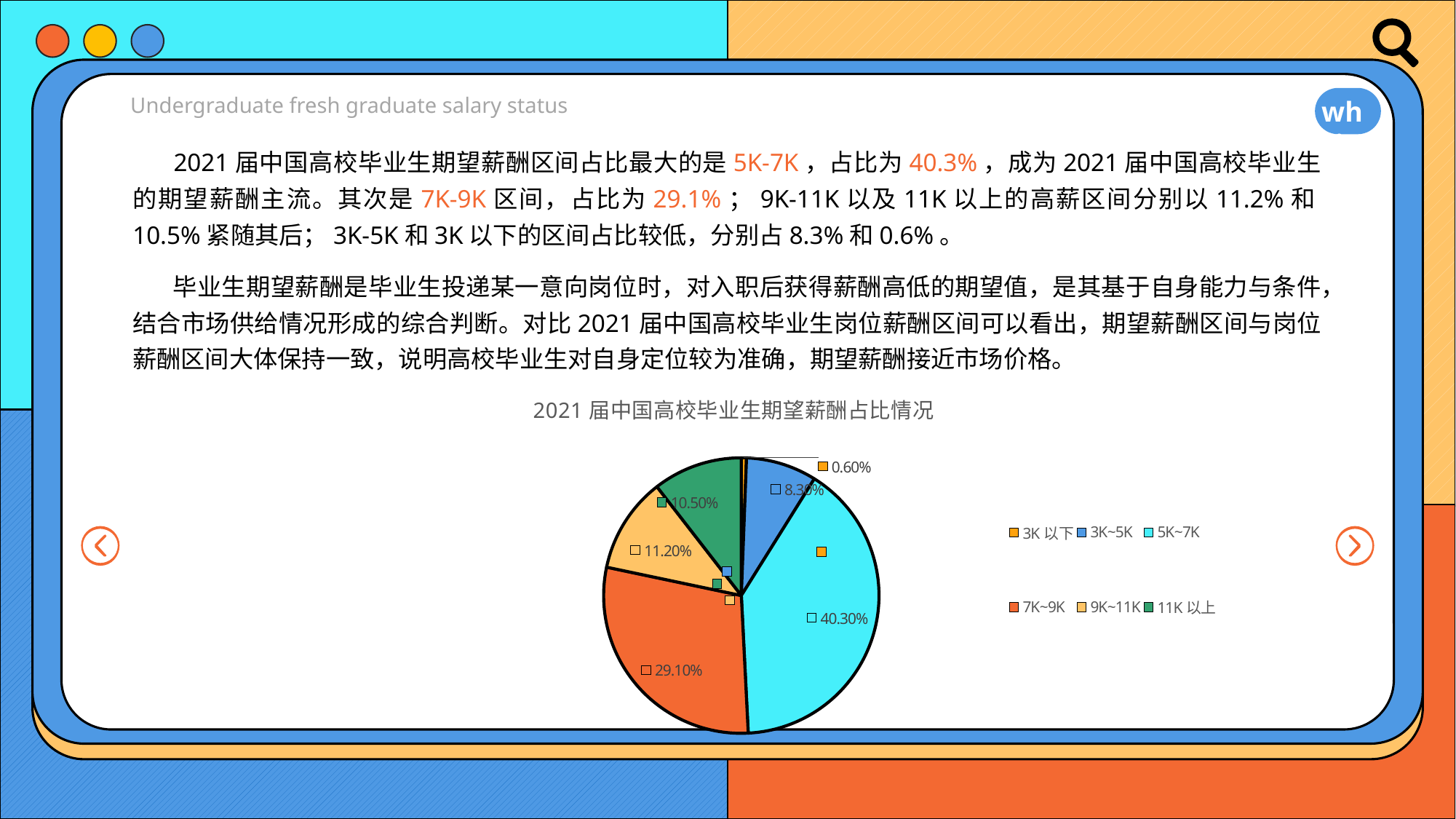
What is the title of the chart? 2021 届中国高校毕业生期望薪酬占比情况 What kind of chart is shown on the slide? pie chart What is the value shown for the 7K~9K slice? 29.10% Which salary range has the smallest share of the pie? 3K 以下 Which salary range has the largest share of the pie? 5K~7K What is the value shown for the 5K~7K slice? 40.30% What is the difference between the 5K~7K share and the 7K~9K share? 11.20% What is the value shown for the 3K 以下 slice? 0.60% What is the value shown for the 11K 以上 slice? 10.50% How many entries does the legend list? 6 How many slices does the pie chart have? 6 What is the value shown for the 9K~11K slice? 11.20%